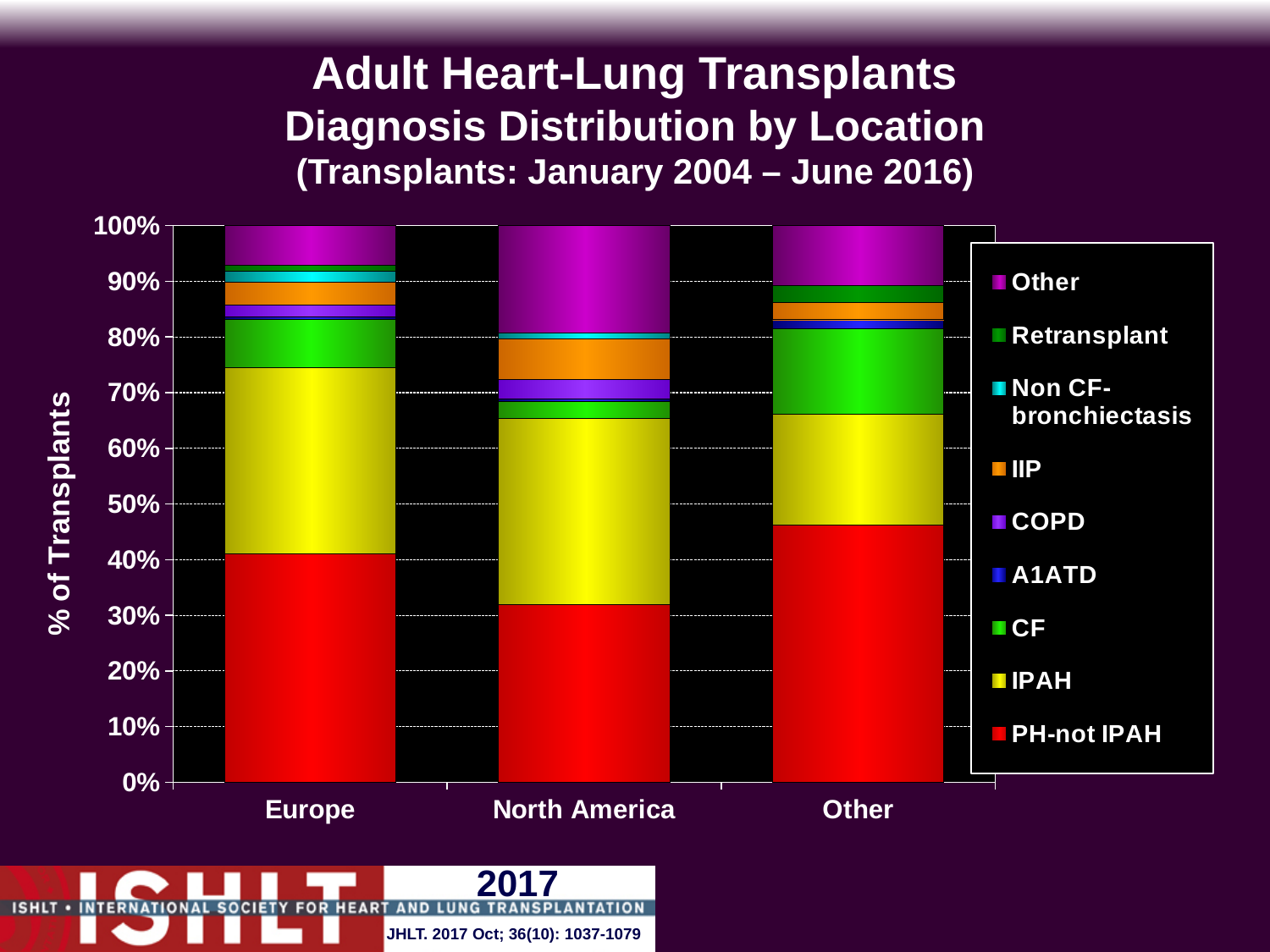
What transplant date range is given in the chart title? January 2004 – June 2016 What kind of chart is shown on the slide? stacked bar chart How many diagnosis series does the legend list? 9 Is the PH-not IPAH share for Europe greater or less than 50%? less Is the PH-not IPAH share for Other greater or less than 40%? greater Which location has the largest PH-not IPAH share of transplants? Other How many locations are shown on the x axis of the chart? 3 Which location has the smallest PH-not IPAH share of transplants? North America What is the label on the y axis of the chart? % of Transplants Is the PH-not IPAH share larger for Other or for North America? Other What does each stacked bar total? 100% Is the PH-not IPAH share for North America greater or less than 40%? less